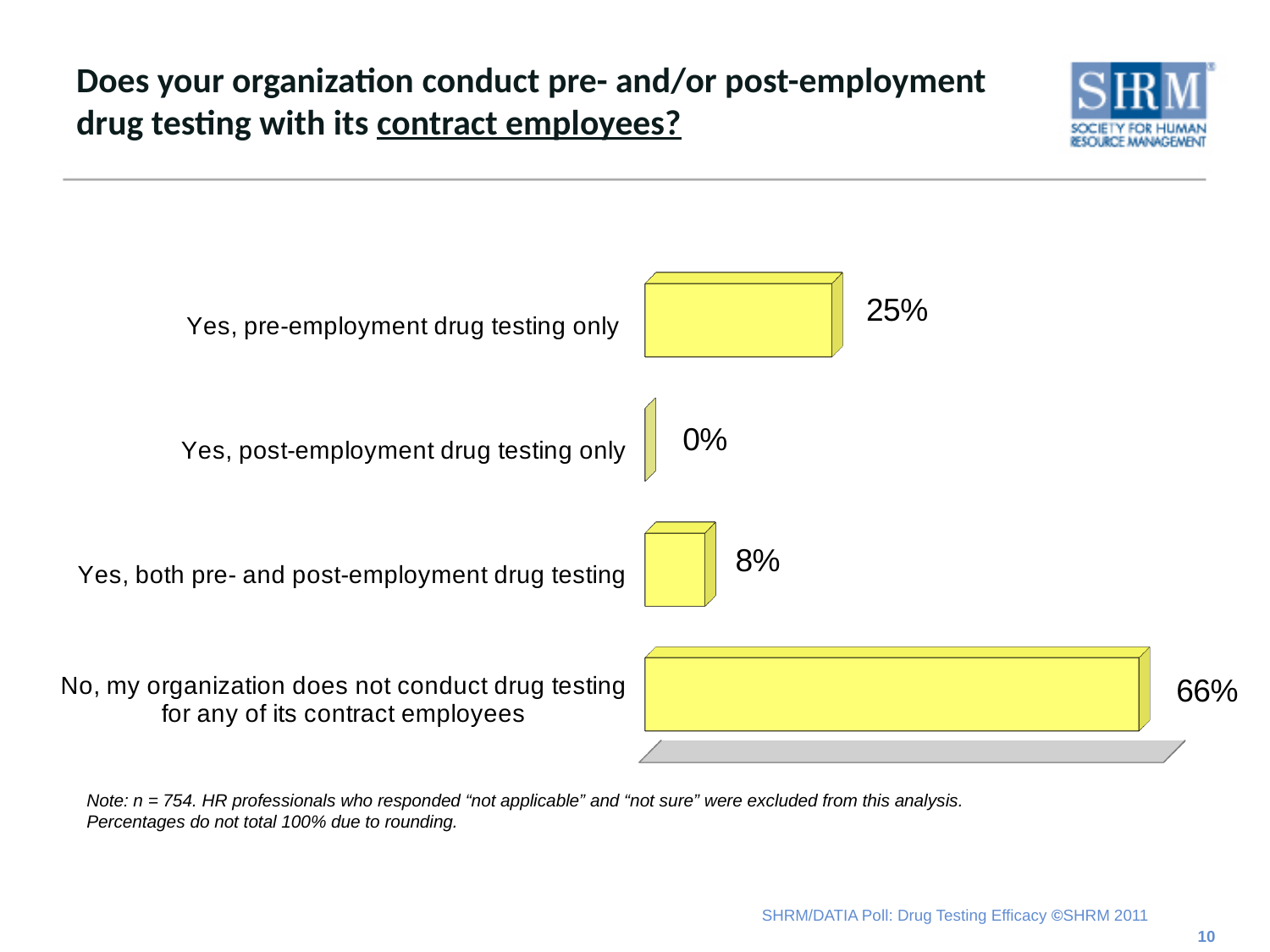
What percentage of organizations conduct both pre- and post-employment drug testing with contract employees? 8% Which response category has the highest percentage? No, my organization does not conduct drug testing for any of its contract employees Which is larger: the percentage for 'Yes, pre-employment drug testing only' or for 'Yes, both pre- and post-employment drug testing'? Yes, pre-employment drug testing only What is the difference in percentage points between 'Yes, pre-employment drug testing only' and 'Yes, both pre- and post-employment drug testing'? 17 What kind of chart is shown on the slide? Bar chart What percentage of organizations do not conduct drug testing for any of their contract employees? 66% What is the difference in percentage points between 'No, my organization does not conduct drug testing for any of its contract employees' and 'Yes, pre-employment drug testing only'? 41 According to the note, how many respondents (n) are included in this analysis? 754 What percentage of organizations conduct pre-employment drug testing only with contract employees? 25% Which response category has the lowest percentage? Yes, post-employment drug testing only What percentage of organizations conduct post-employment drug testing only with contract employees? 0% How many response categories are shown in the chart? 4